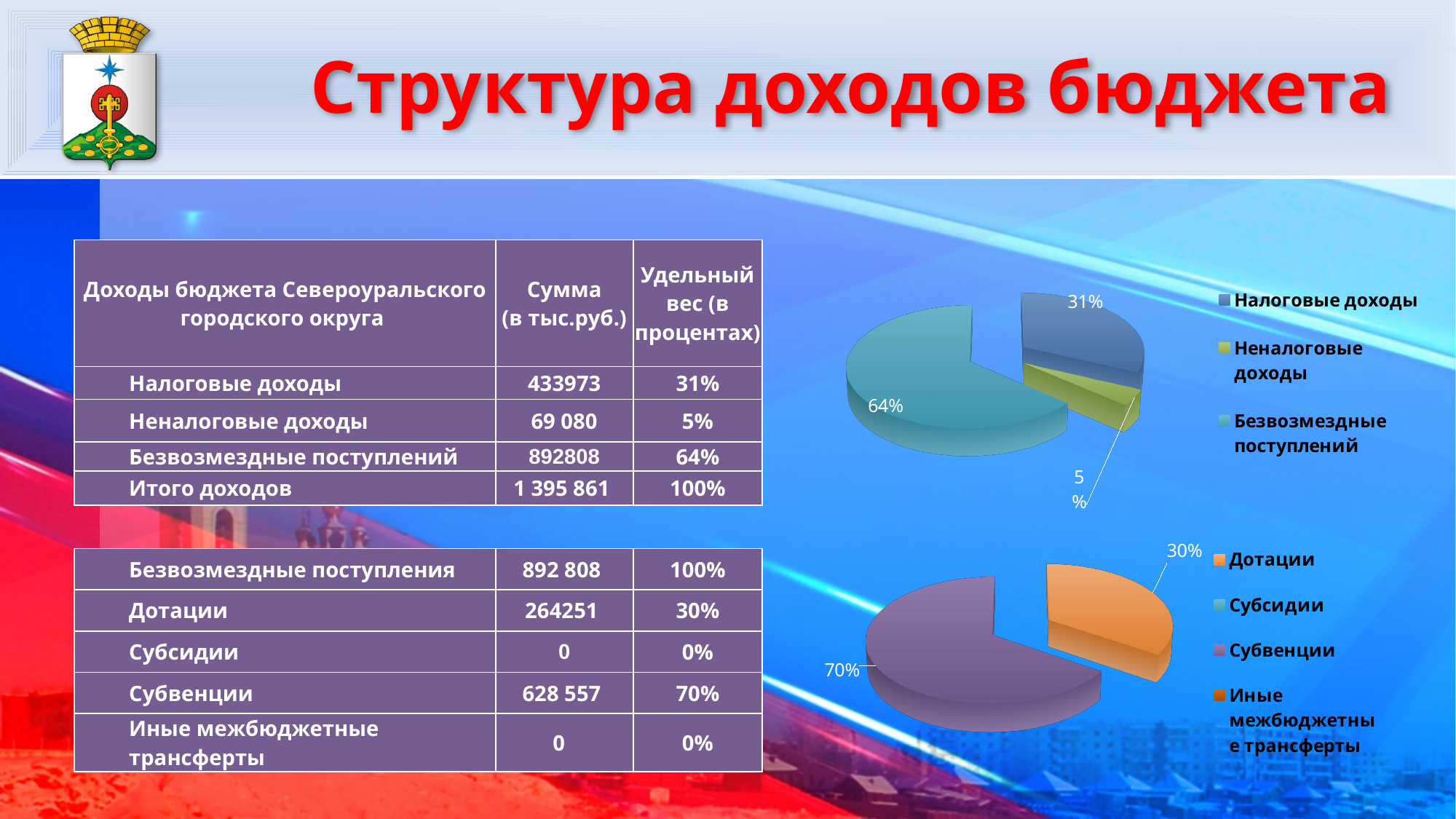
In the upper pie chart, which category has the smallest slice? Неналоговые доходы What type of chart is the upper chart on the right side of the slide? pie chart In the upper pie chart, which category has the largest slice? Безвозмездные поступлений In the upper pie chart, what share is shown for Неналоговые доходы? 5% In the lower pie chart, which is larger, Дотации or Субвенции? Субвенции In the upper pie chart, what is the difference in percentage points between Безвозмездные поступлений and Налоговые доходы? 33 In the lower pie chart, what share is shown for Субвенции? 70% How many entries does the legend of the lower pie chart list? 4 In the lower pie chart, what share is shown for Дотации? 30% How many entries does the legend of the upper pie chart list? 3